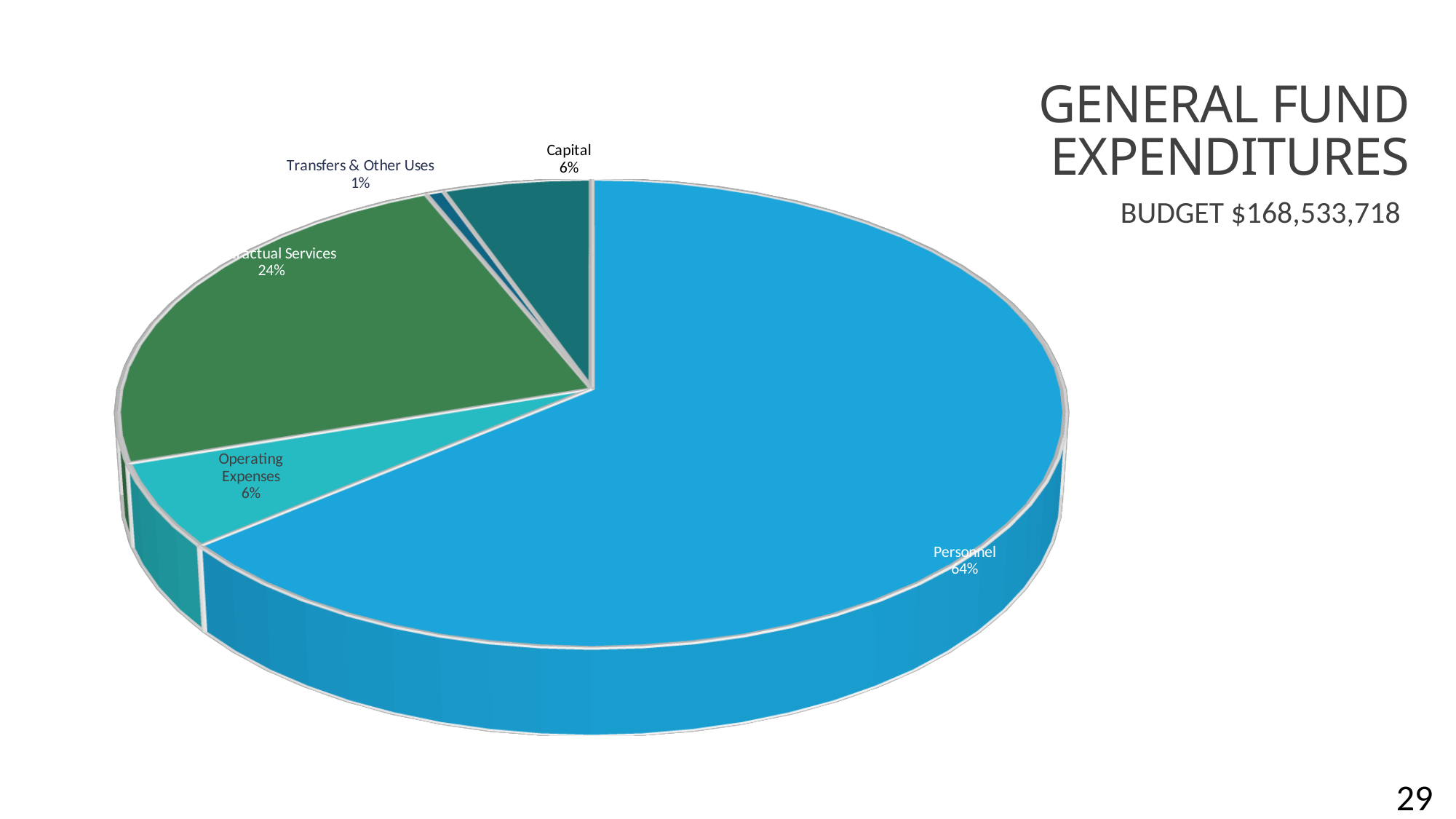
What is the title of the chart on the slide? GENERAL FUND EXPENDITURES How many slices does the pie chart have? 5 Which category has the smallest share of General Fund Expenditures? Transfers & Other Uses What percentage of General Fund Expenditures is Transfers & Other Uses? 1% What percentage of General Fund Expenditures is Operating Expenses? 6% What percentage of General Fund Expenditures is Personnel? 64% How many percentage points larger is the Personnel share than the Capital share? 58 percentage points What percentage of General Fund Expenditures is Capital? 6% Which is larger, the Capital share or the Transfers & Other Uses share? Capital Which category has the largest share of General Fund Expenditures? Personnel What kind of chart is shown on the slide? Pie chart What total budget amount is stated on the slide? $168,533,718